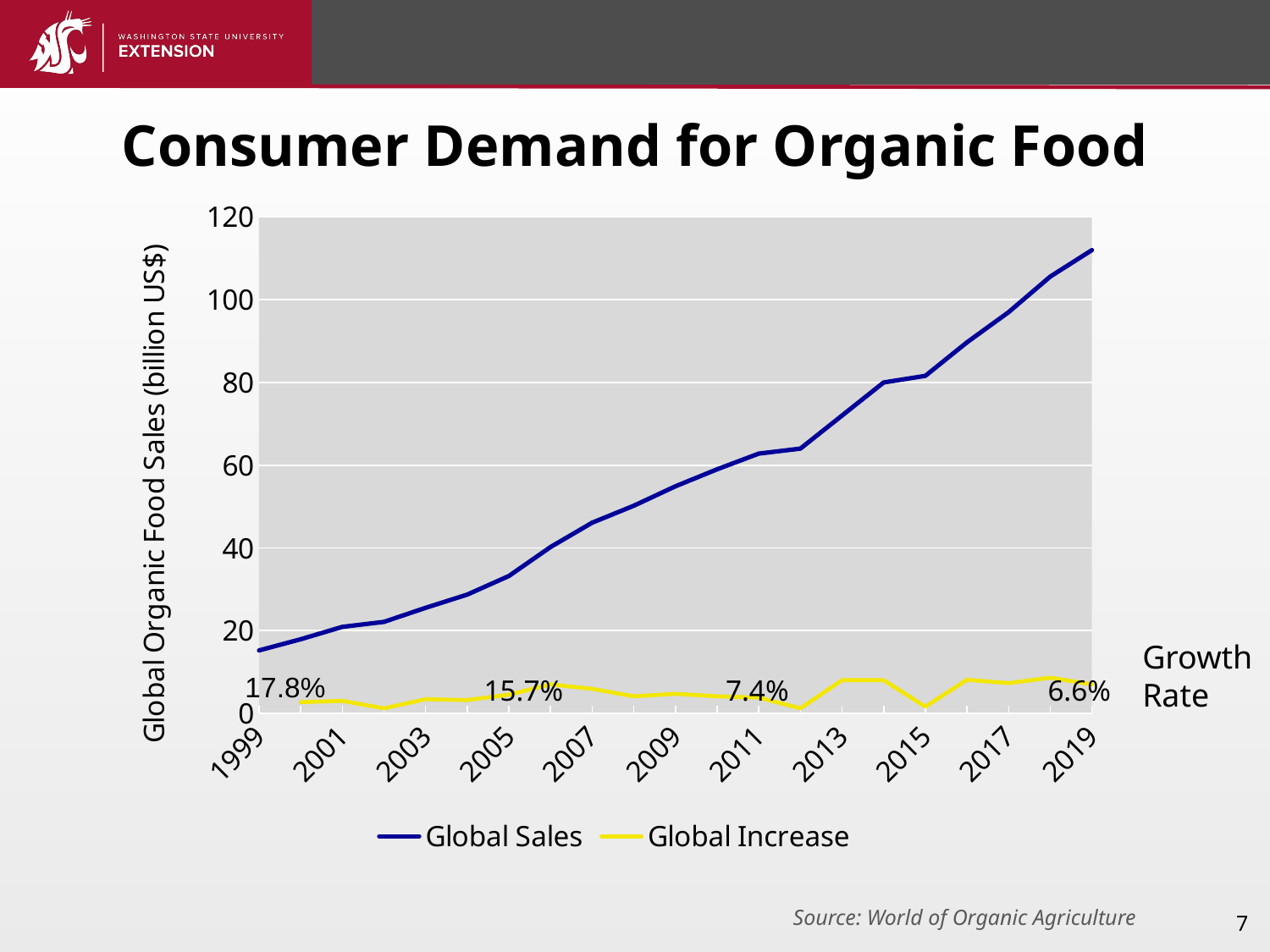
What kind of chart is shown on the slide? line chart In which year is Global Sales highest? 2019 In which year is Global Sales lowest? 1999 Does the Global Sales line rise or fall from 1999 to 2019? rise How many year labels are shown on the x axis? 11 Is the Global Sales value for 2009 greater or less than 60? less What is the first growth rate label shown on the Global Increase line, at the left of the chart? 17.8% Is the Global Sales value for 1999 greater or less than 20? less What are the two series named in the legend? Global Sales and Global Increase How many series does the legend list? 2 What is the title of the vertical axis? Global Organic Food Sales (billion US$) Is the Global Sales value for 2019 greater or less than 100? greater